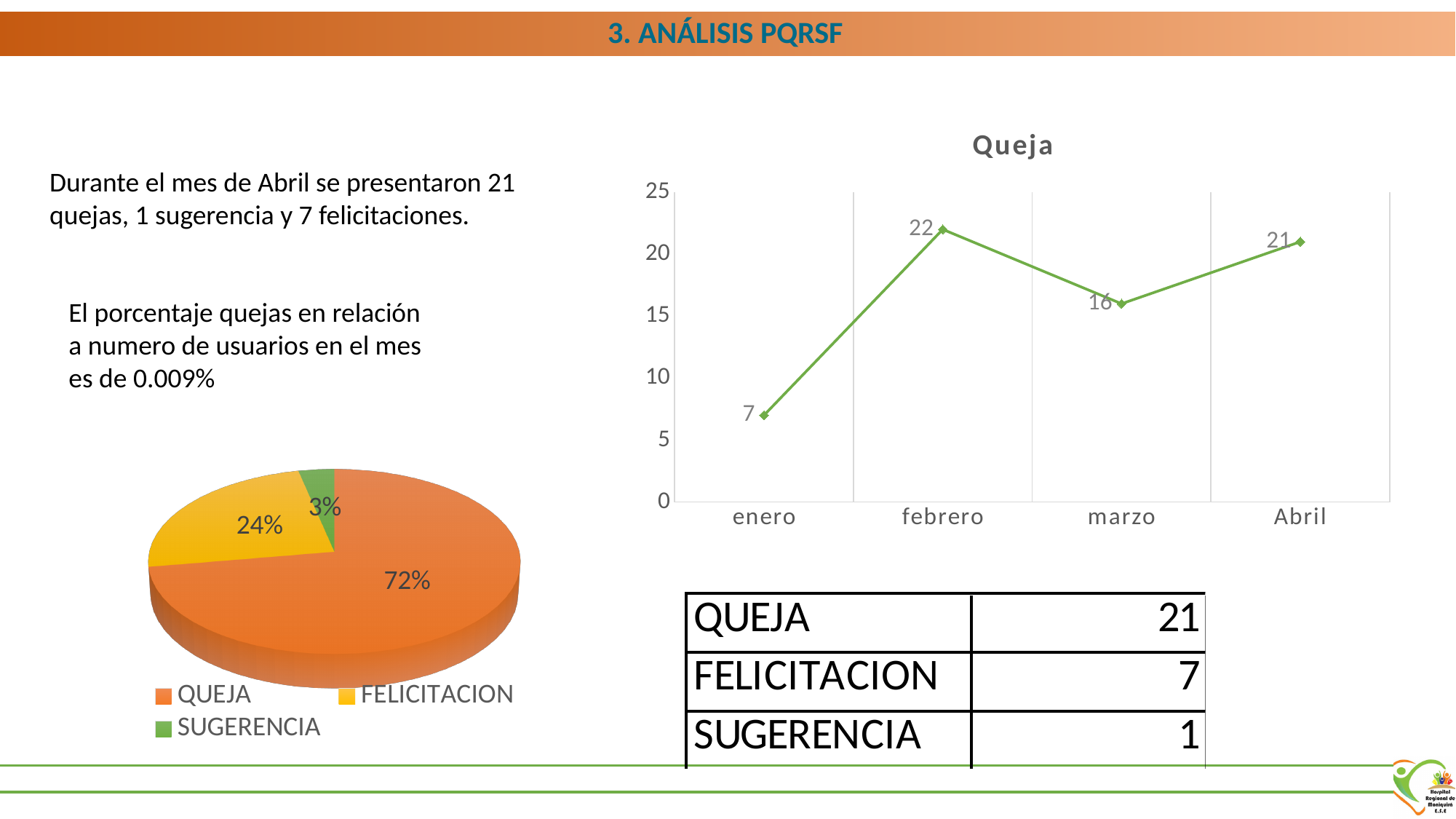
In the pie chart, how many categories does the legend list? 3 In the 'Queja' line chart, what is the value for enero? 7 In the 'Queja' line chart, which is larger, the value for marzo or the value for Abril? Abril In the pie chart, what share does QUEJA have? 72% In the 'Queja' line chart, which month has the highest value? febrero What kind of chart is the chart on the left of the slide? pie chart In the 'Queja' line chart, what is the value for febrero? 22 In the 'Queja' line chart, how many months are plotted on the x axis? 4 In the pie chart, what share does FELICITACION have? 24% In the 'Queja' line chart, does the value rise or fall from enero to febrero? rise In the 'Queja' line chart, which month has the lowest value? enero In the 'Queja' line chart, what is the difference between the values for febrero and marzo? 6